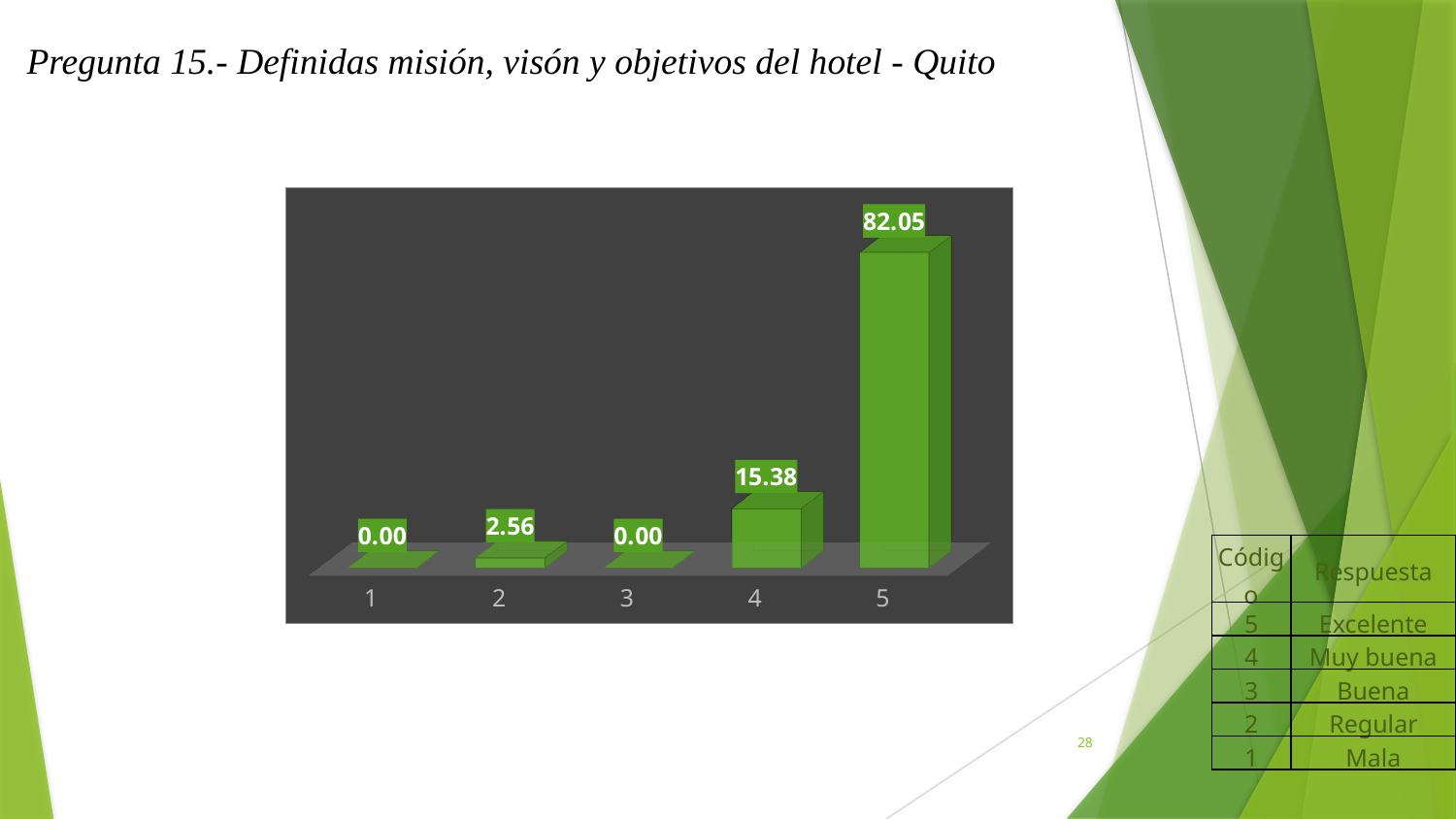
What colour are the bars in the chart? green Which is larger, the value for category 2 or the value for category 4? 4 What is the value for category 5? 82.05 What kind of chart is shown on the slide? bar chart Which category has the highest value? 5 What is the difference between the values for category 4 and category 2? 12.82 What is the value for category 1? 0.00 What is the value for category 4? 15.38 What is the difference between the values for category 5 and category 4? 66.67 How many categories are shown on the x axis? 5 Which categories have a value of 0.00? 1 and 3 What is the value for category 2? 2.56